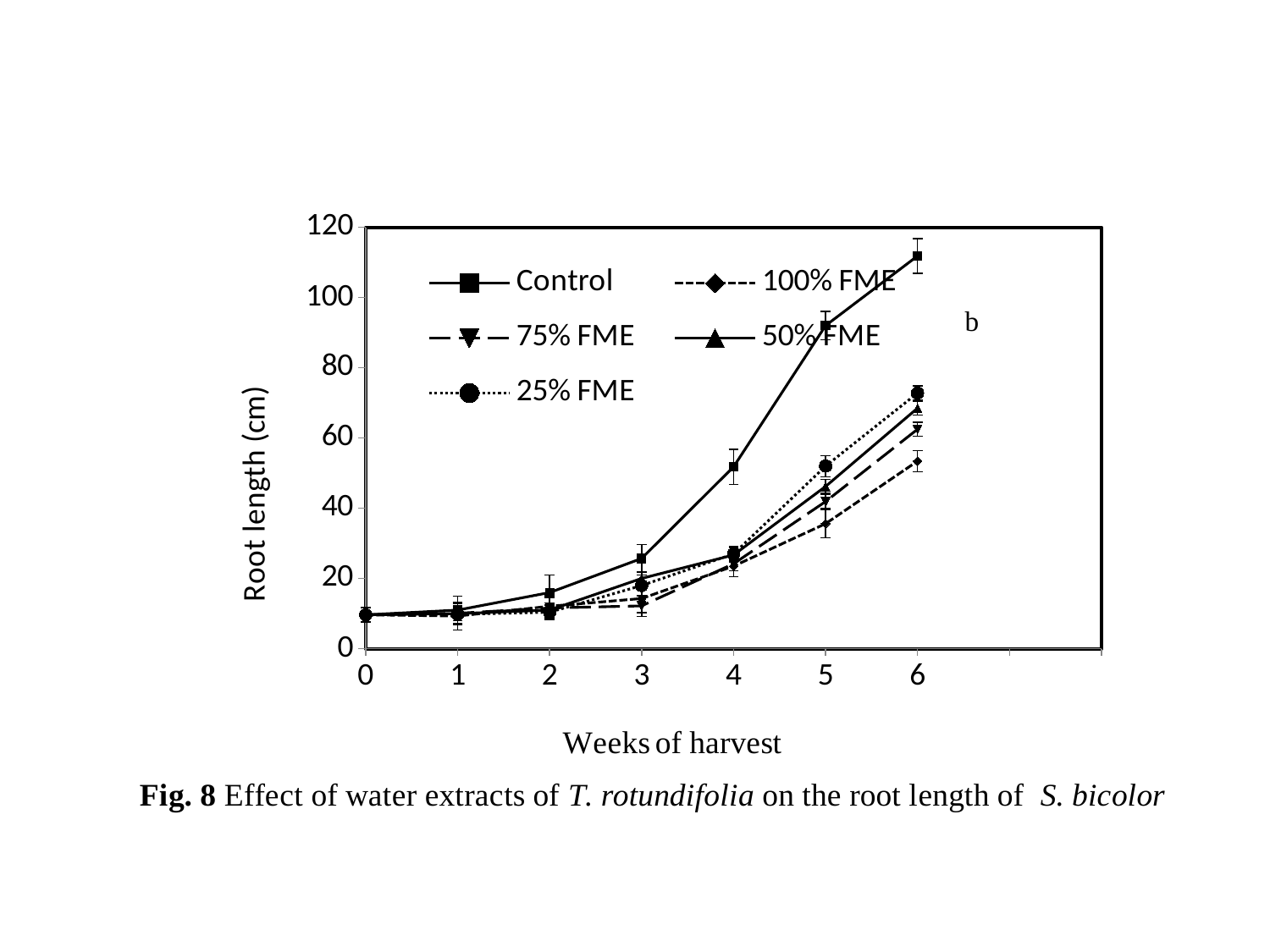
What kind of chart is shown on the slide? line chart At week 6, which has the larger root length: 25% FME or 100% FME? 25% FME Which series has the highest root length at week 6? Control Which series has the lowest root length at week 6? 100% FME At week 5, which has the larger root length: Control or 25% FME? Control How many series does the legend list? 5 Is the root length for Control at week 4 greater or less than 40? greater Does the root length for Control rise or fall as the weeks of harvest increase? rises What is the label of the y axis? Root length (cm) Is the root length for 100% FME at week 6 greater or less than 60? less Is the root length for 25% FME at week 6 greater or less than 60? greater